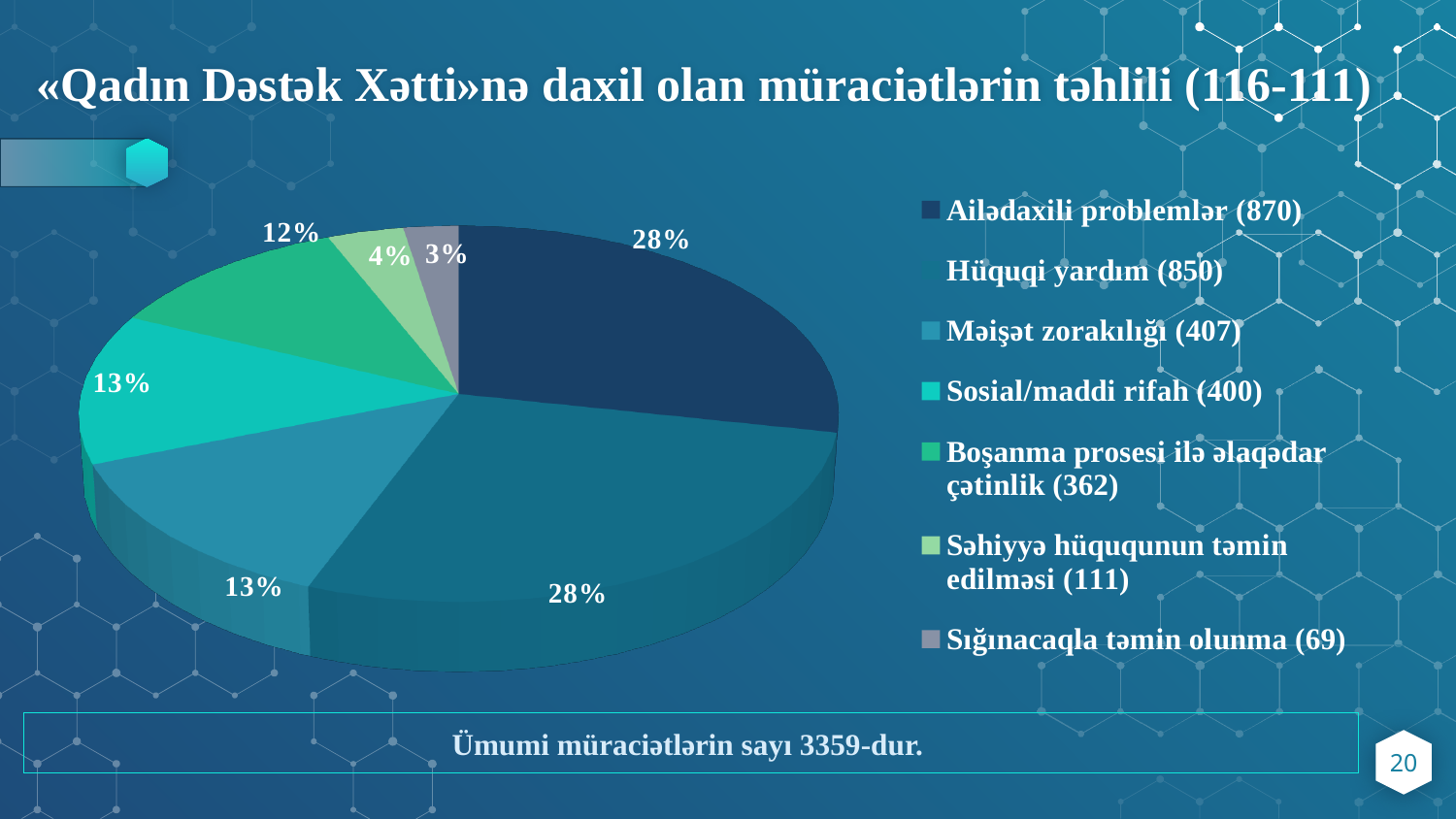
According to the legend, how many cases are listed for Məişət zorakılığı? 407 What share of the pie does Səhiyyə hüququnun təmin edilməsi represent? 4% Which category has the largest number of cases according to the legend? Ailədaxili problemlər What share of the pie does Boşanma prosesi ilə əlaqədar çətinlik represent? 12% What share of the pie does Ailədaxili problemlər represent? 28% Which category has the smallest slice of the pie? Sığınacaqla təmin olunma How many categories does the pie chart's legend list? 7 Which slice is larger: Boşanma prosesi ilə əlaqədar çətinlik or Səhiyyə hüququnun təmin edilməsi? Boşanma prosesi ilə əlaqədar çətinlik According to the legend, how many cases are listed for Sosial/maddi rifah? 400 What is the difference between the number of cases for Ailədaxili problemlər and Hüquqi yardım as shown in the legend? 20 What kind of chart is shown on the slide? pie chart